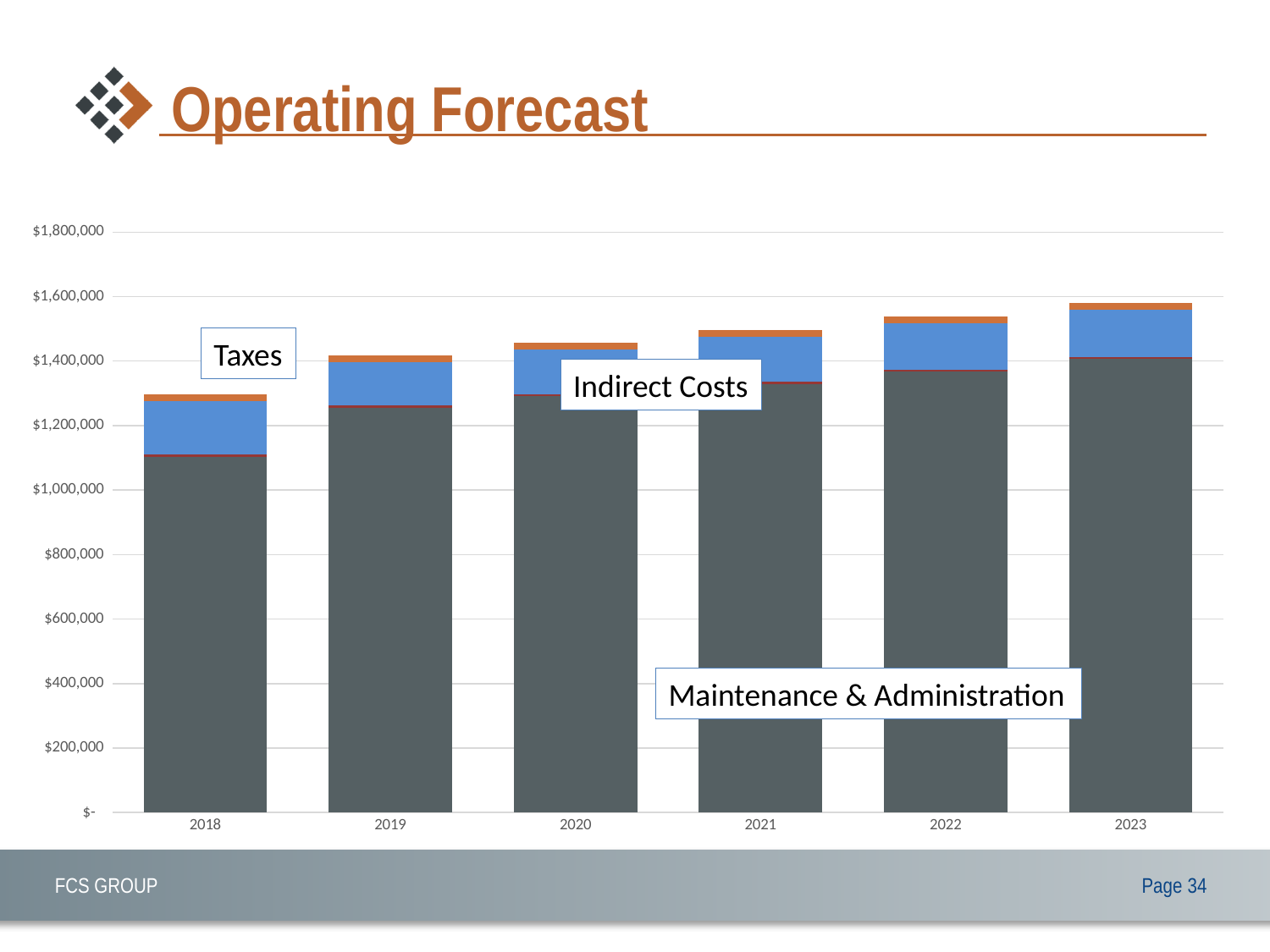
What kind of chart is shown on the slide? Stacked bar chart Which year has the highest total operating cost in the chart? 2023 How many years are shown on the x axis of the chart? 6 Which year has the lowest total operating cost in the chart? 2018 What is the title of the slide containing the chart? Operating Forecast How many cost categories are labelled in the chart? 3 Which cost category is shown as the largest (dark gray) segment of each bar? Maintenance & Administration Is the total operating cost for 2023 greater or less than $1,600,000? less Which year has the larger total operating cost, 2019 or 2021? 2021 Is the total operating cost for 2018 greater or less than $1,200,000? greater Do the total operating costs rise or fall from 2018 to 2023? Rise Is the Maintenance & Administration value for 2018 greater or less than $1,000,000? greater